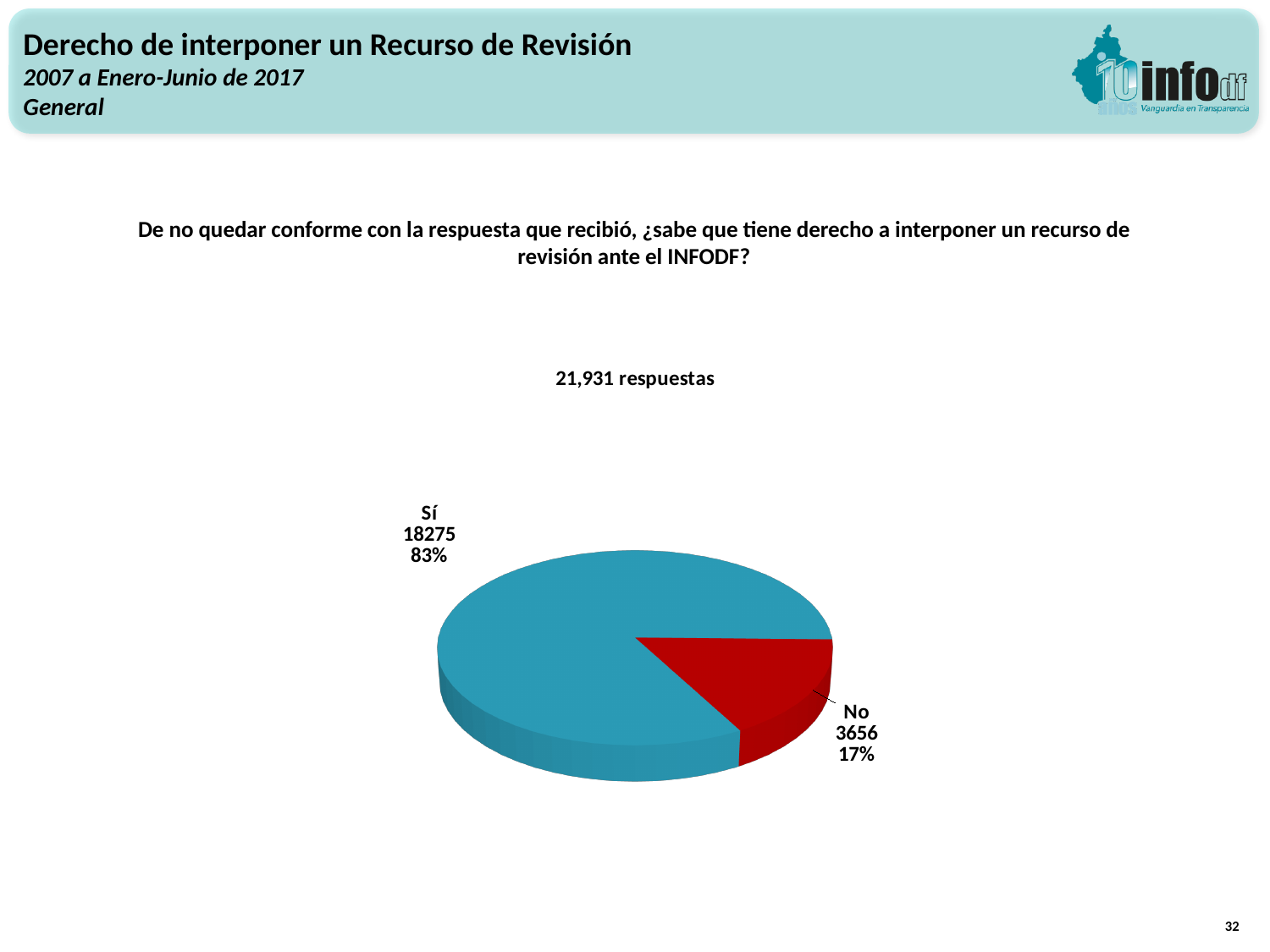
Which is larger, the number of "Sí" responses or the number of "No" responses? Sí What colour is the "No" slice of the pie? Red What is the number of responses for "Sí"? 18275 How many responses does the chart report in total? 21,931 respuestas How many categories are shown in the pie chart? 2 What percentage of the pie does the "Sí" slice represent? 83% Which category has the smallest slice of the pie? No What kind of chart is shown on the slide? Pie chart What is the number of responses for "No"? 3656 What percentage of the pie does the "No" slice represent? 17% Which category has the largest slice of the pie? Sí What is the difference between the number of "Sí" responses and "No" responses? 14619